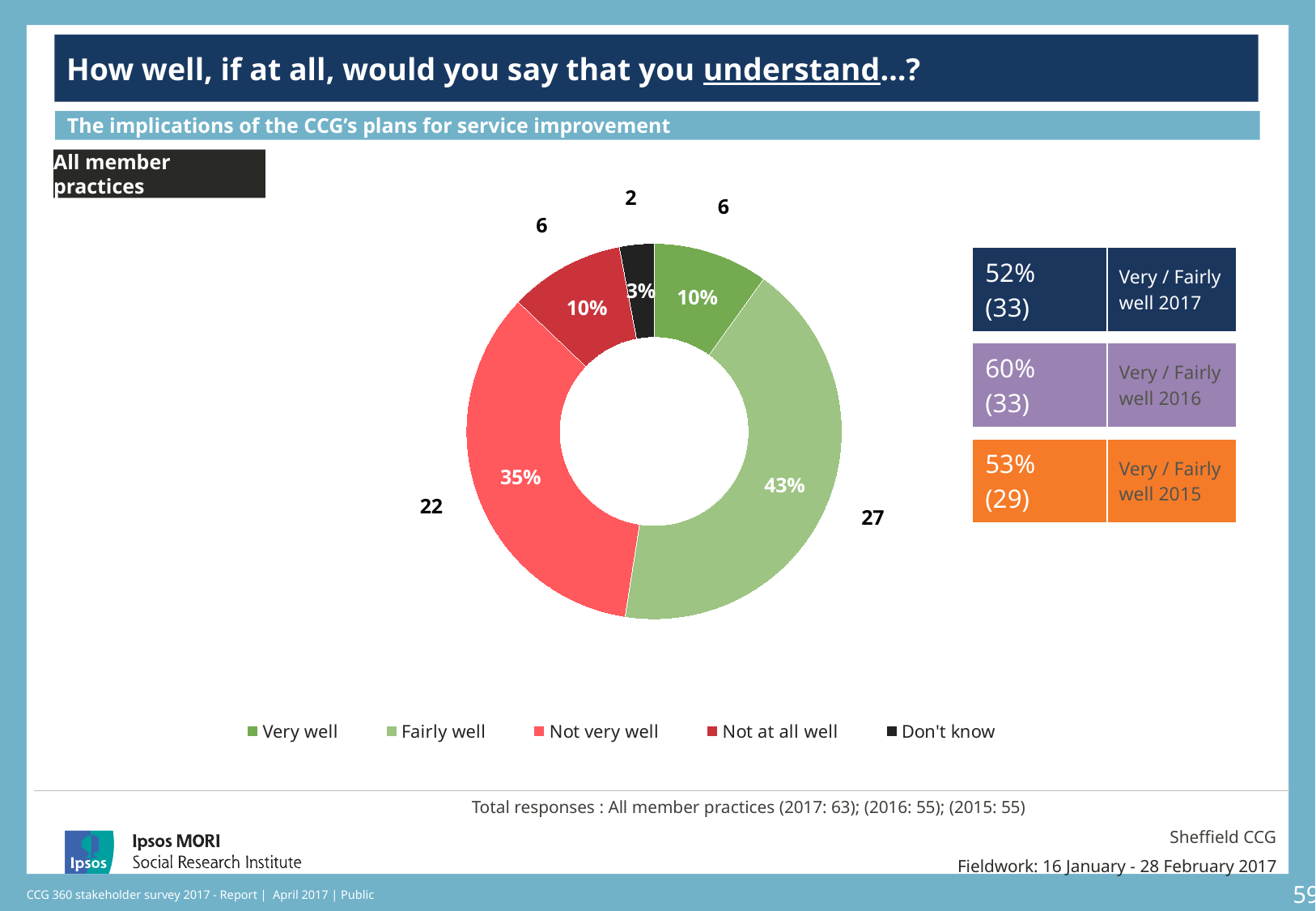
What colour represents 'Not at all well' in the chart? Dark red Which response category has the largest share of the donut chart? Fairly well What type of chart is used on this slide? Donut (pie) chart What percentage of respondents answered 'Don't know'? 3% How many respondents (count) answered 'Not very well'? 22 What percentage of respondents said they understand the implications of the CCG's plans for service improvement 'Fairly well'? 43% What percentage of respondents answered 'Not very well'? 35% How many respondents (count) answered 'Fairly well'? 27 What is the difference in percentage points between 'Fairly well' and 'Not very well'? 8 percentage points Which is larger, the share for 'Very well' or the share for 'Not very well'? Not very well How many response categories does the legend list? 5 Which response category has the smallest share of the donut chart? Don't know